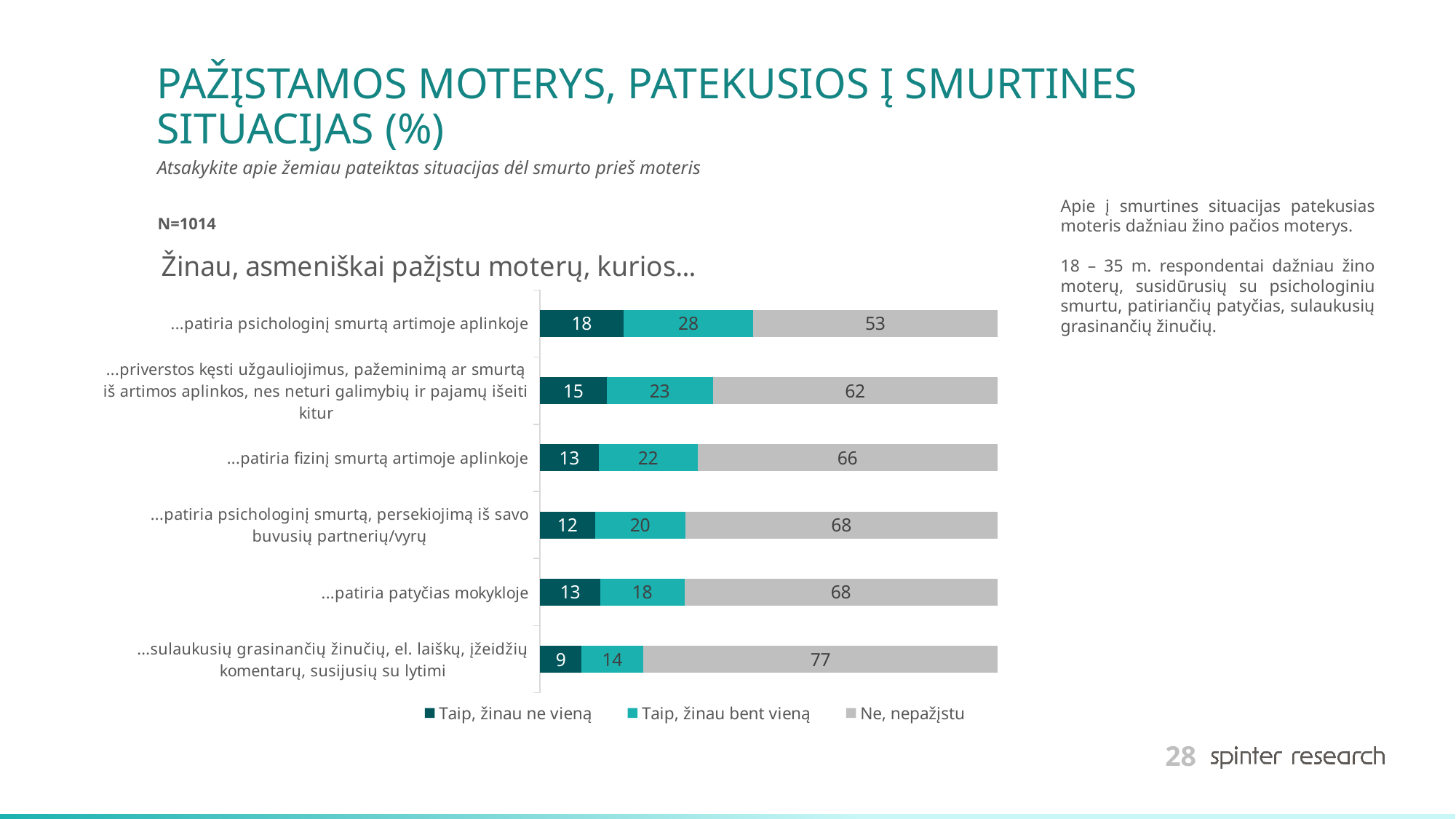
What is the difference between the "Ne, nepažįstu" values for "...patiria fizinį smurtą artimoje aplinkoje" and "...patiria psichologinį smurtą artimoje aplinkoje"? 13 Which is larger: the "Taip, žinau bent vieną" value for "...patiria patyčias mokykloje" or for "...priverstos kęsti užgauliojimus, pažeminimą ar smurtą iš artimos aplinkos, nes neturi galimybių ir pajamų išeiti kitur"? ...priverstos kęsti užgauliojimus, pažeminimą ar smurtą iš artimos aplinkos, nes neturi galimybių ir pajamų išeiti kitur What is the value of "Taip, žinau bent vieną" for "...patiria fizinį smurtą artimoje aplinkoje"? 22 What is the value of "Ne, nepažįstu" for "...sulaukusių grasinančių žinučių, el. laiškų, įžeidžių komentarų, susijusių su lytimi"? 77 What is the value of "Taip, žinau ne vieną" for "...patiria psichologinį smurtą artimoje aplinkoje"? 18 What is the total of the stacked bar for "...patiria psichologinį smurtą, persekiojimą iš savo buvusių partnerių/vyrų"? 100 Which category has the lowest value for "Taip, žinau ne vieną"? ...sulaukusių grasinančių žinučių, el. laiškų, įžeidžių komentarų, susijusių su lytimi What is the sample size (N) shown on the slide? N=1014 Which category has the highest value for "Ne, nepažįstu"? ...sulaukusių grasinančių žinučių, el. laiškų, įžeidžių komentarų, susijusių su lytimi How many series does the legend list? 3 What kind of chart is shown on the slide? Stacked bar chart How many categories are plotted in the chart? 6